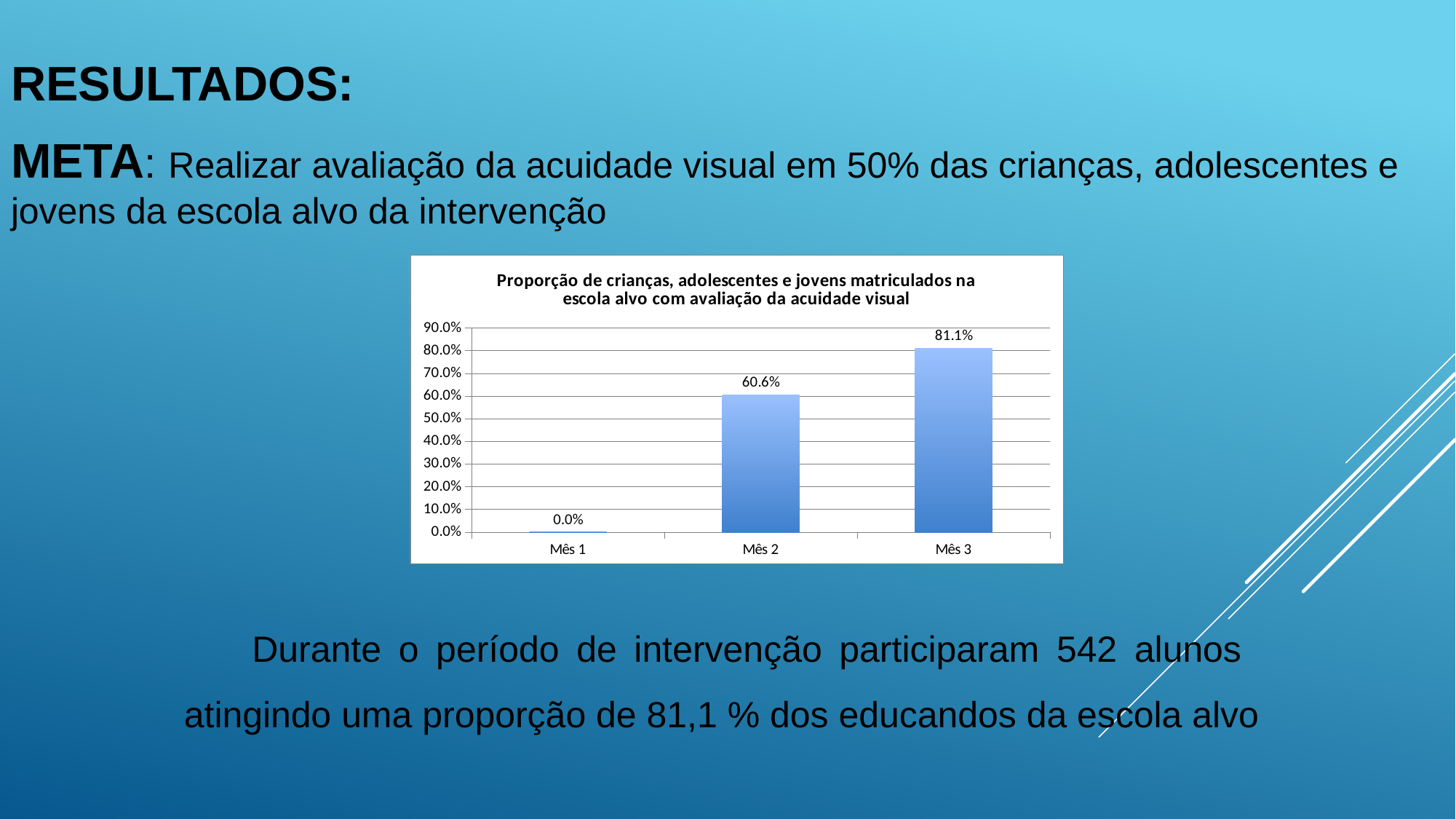
What is the highest value shown on the y axis? 90.0% What is the value for Mês 1? 0.0% Which month has the lowest value? Mês 1 What kind of chart is shown on the slide? bar chart What is the value for Mês 3? 81.1% Is the value for Mês 2 greater or less than 50.0%? greater What is the value for Mês 2? 60.6% How many months are shown on the x axis? 3 Which month has the highest value? Mês 3 Which is larger, the value for Mês 2 or the value for Mês 3? Mês 3 Do the values rise or fall from Mês 1 to Mês 3? rise What is the difference between the values for Mês 3 and Mês 2? 20.5%